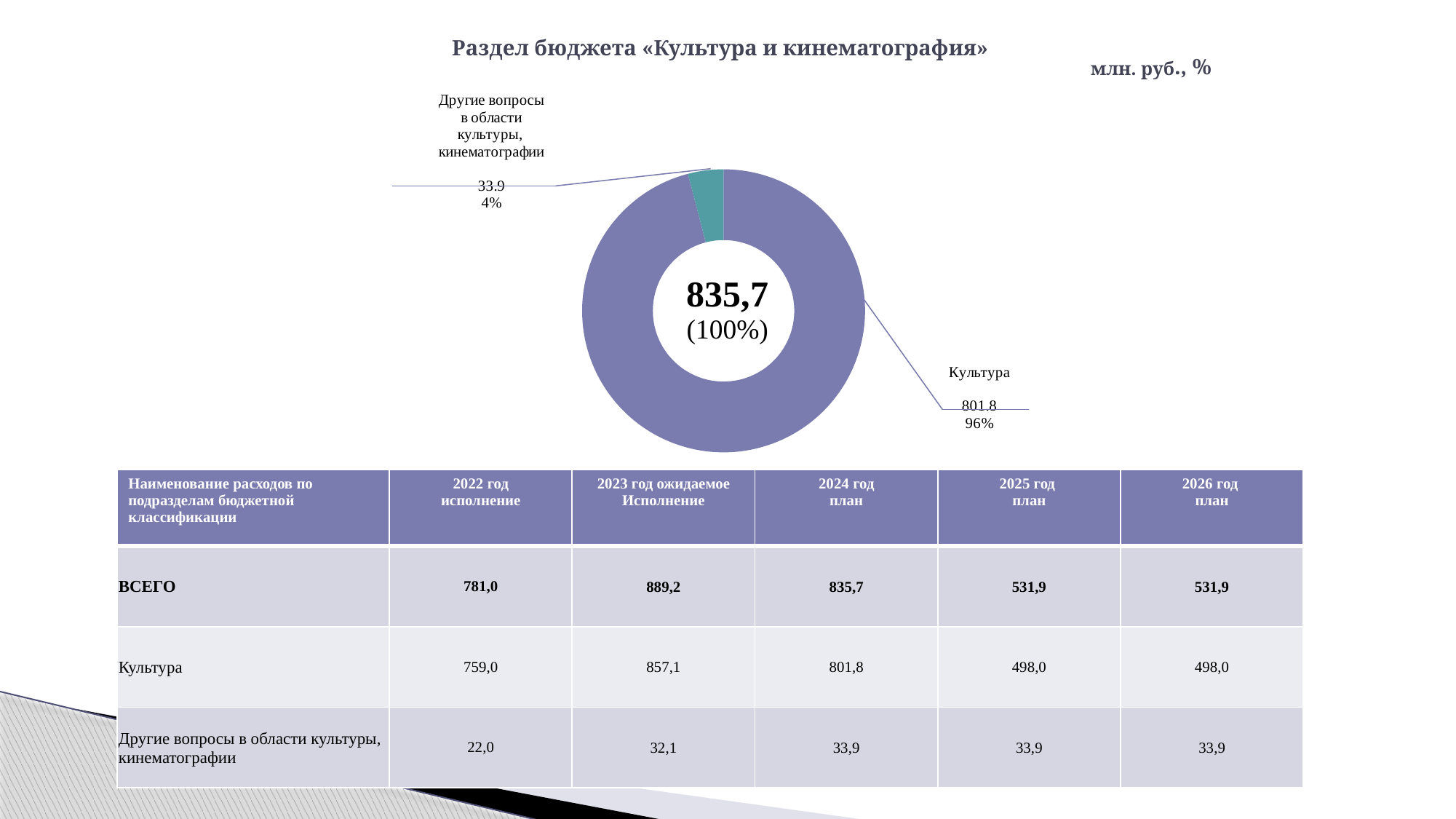
What share of the doughnut does the Культура slice represent? 96% What share of the doughnut does the slice Другие вопросы в области культуры, кинематографии represent? 4% What total value is shown in the centre of the doughnut chart? 835,7 (100%) What is the difference between the Культура value and the Другие вопросы в области культуры, кинематографии value in the chart? 767.9 What is the value shown for the Культура slice? 801.8 What is the value shown for the slice Другие вопросы в области культуры, кинематографии? 33.9 Which slice of the doughnut chart is the smallest? Другие вопросы в области культуры, кинематографии Which slice of the doughnut chart is the largest? Культура How many slices does the doughnut chart have? 2 What is the title of the chart on the slide? Раздел бюджета «Культура и кинематография» What kind of chart is shown on the slide? Doughnut (pie) chart Which is larger in the chart: Культура or Другие вопросы в области культуры, кинематографии? Культура